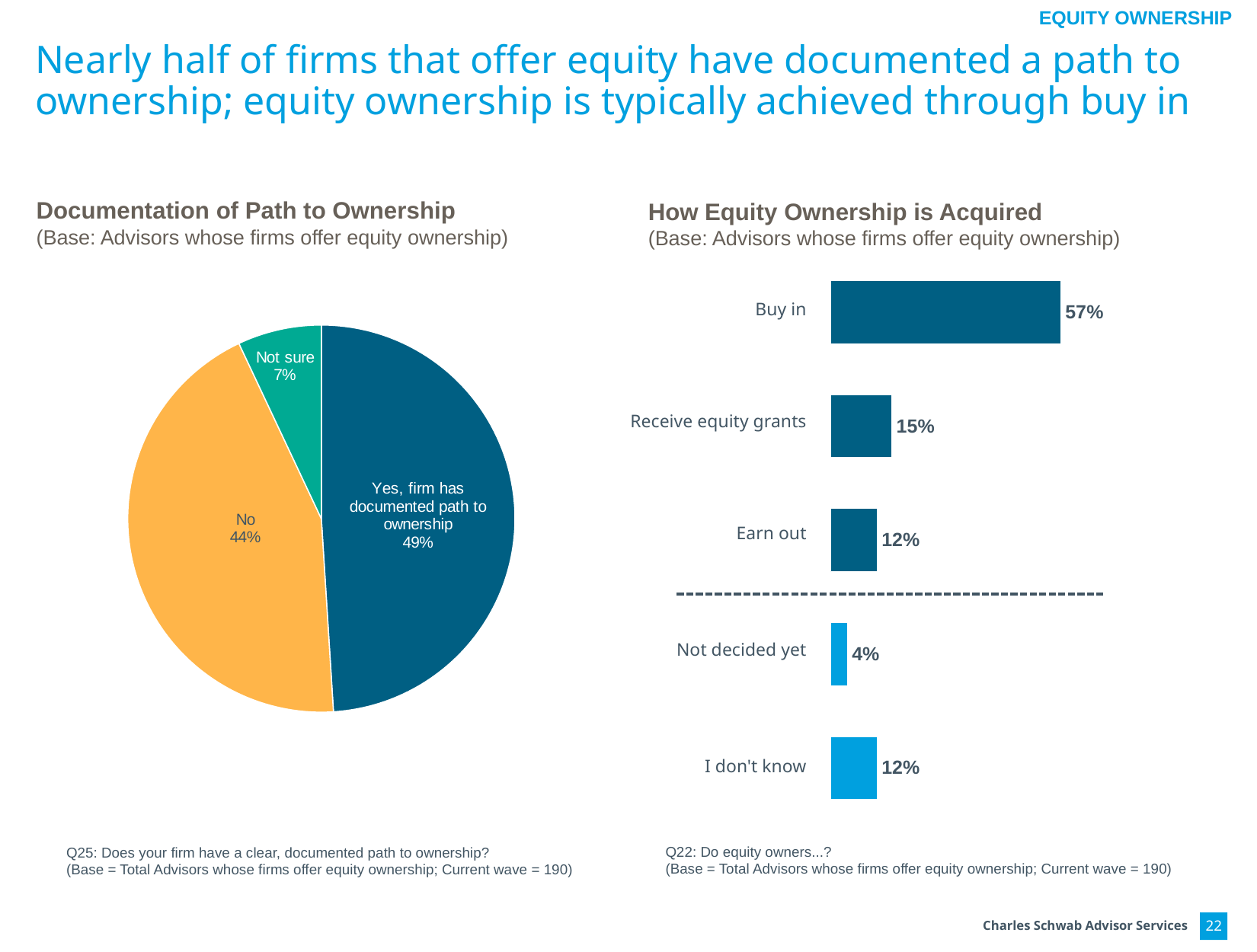
In the 'How Equity Ownership is Acquired' chart, which category has the highest value? Buy in What kind of chart is 'Documentation of Path to Ownership'? Pie chart In the 'How Equity Ownership is Acquired' chart, what is the value for 'Buy in'? 57% In the 'Documentation of Path to Ownership' chart, which slice is the smallest? Not sure In the 'How Equity Ownership is Acquired' chart, what is the difference between 'Buy in' and 'Earn out'? 45% In the 'How Equity Ownership is Acquired' chart, what is the value for 'Receive equity grants'? 15% In the 'Documentation of Path to Ownership' chart, what share of advisors said their firm has a documented path to ownership? 49% In the 'Documentation of Path to Ownership' chart, what percentage answered 'No'? 44% In the 'How Equity Ownership is Acquired' chart, which category has the lowest value? Not decided yet What kind of chart is 'How Equity Ownership is Acquired'? Bar chart In the 'Documentation of Path to Ownership' chart, what is the difference between the 'Yes' and 'No' shares? 5% In the 'Documentation of Path to Ownership' chart, how many slices does the pie have? 3